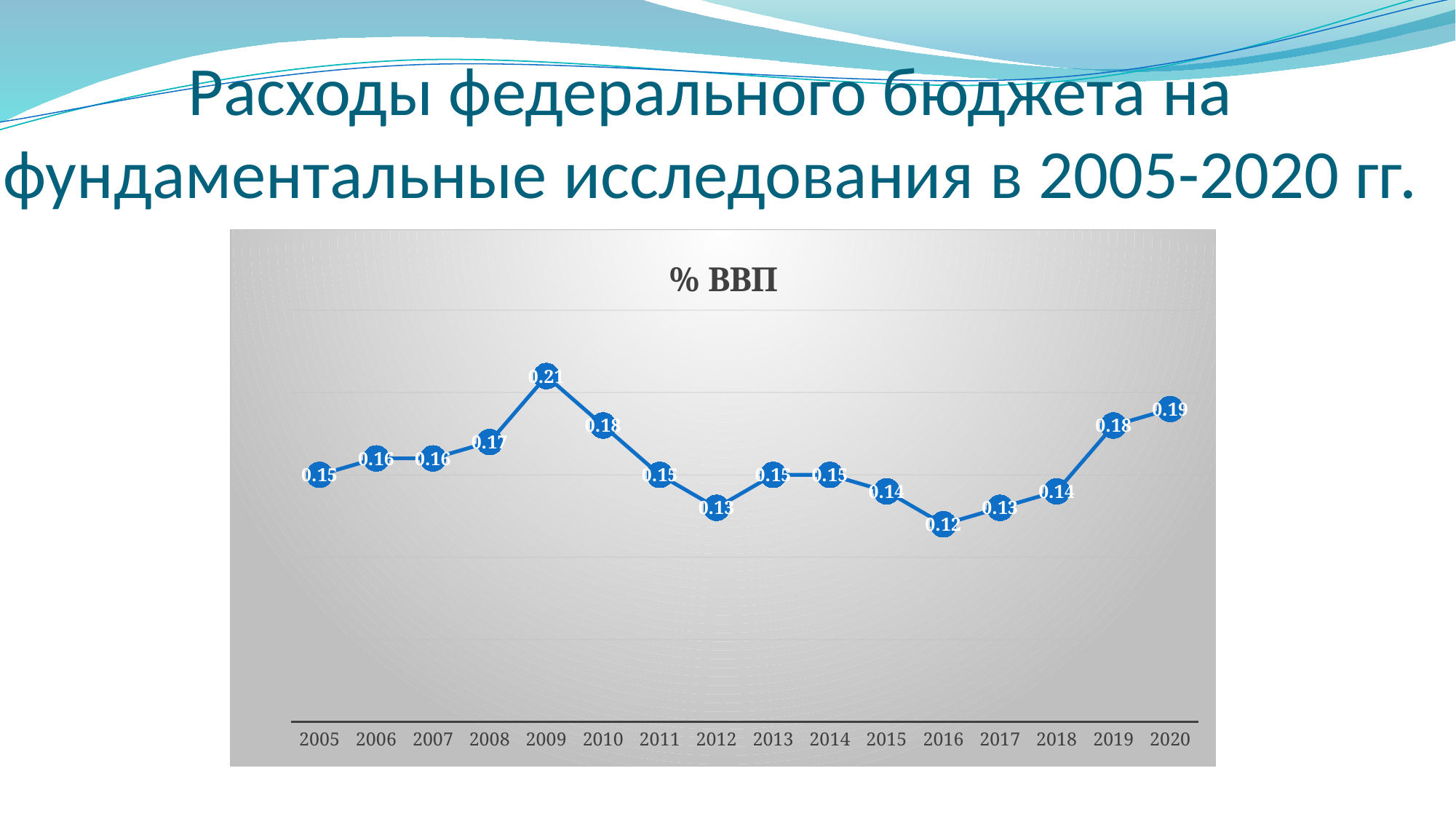
Which year has the lowest value? 2016 Which is larger, the value for 2012 or the value for 2008? 2008 How many years are plotted on the x axis? 16 What is the difference between the values for 2009 and 2016? 0.09 What is the value for 2009? 0.21 Which is larger, the value for 2010 or the value for 2019? They are equal (0.18) What is the value for 2005? 0.15 What is the value for 2016? 0.12 What is the value for 2020? 0.19 Which year has the highest value? 2009 What is the title of the chart? % ВВП What kind of chart is shown? Line chart